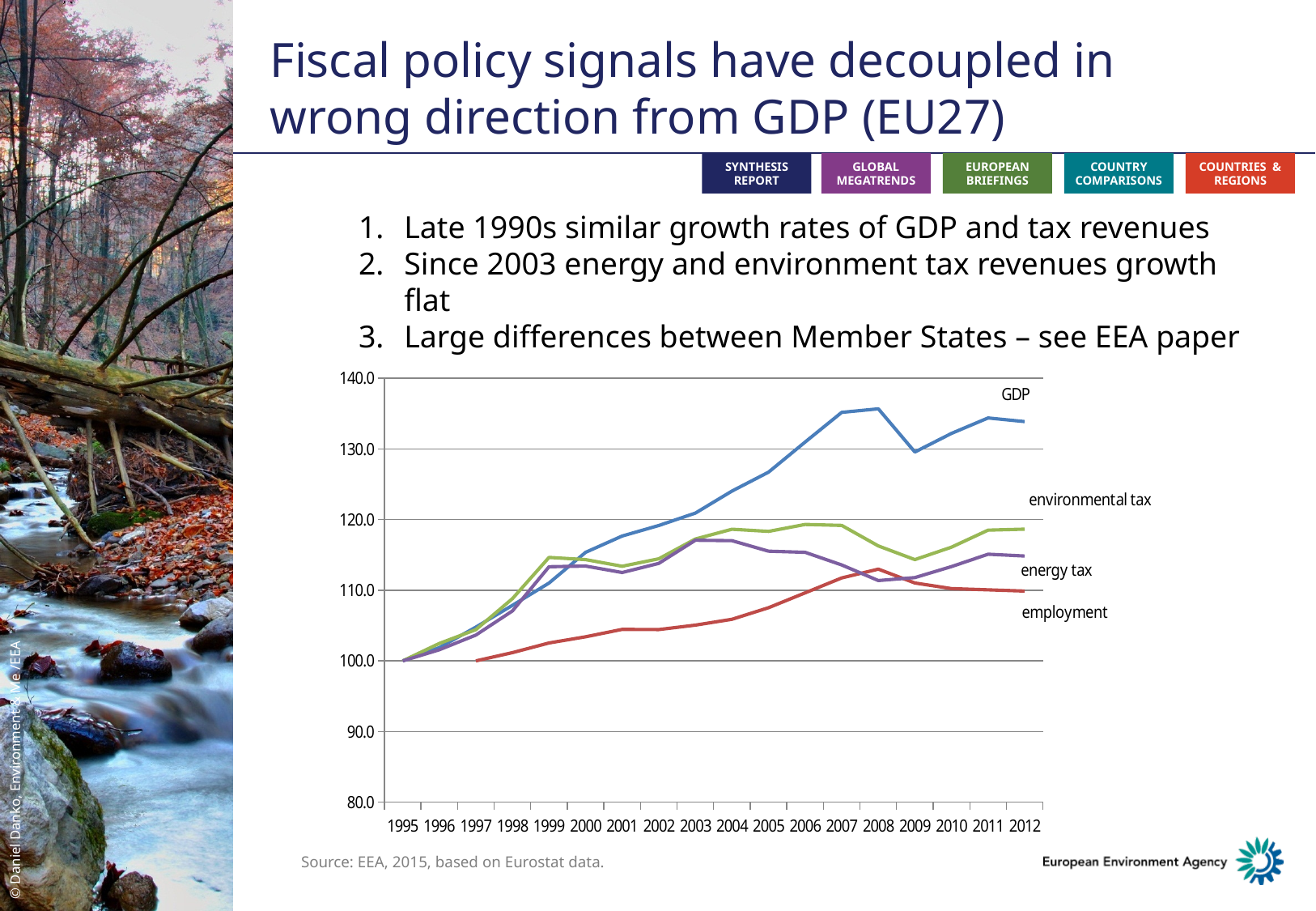
How many years are shown along the x axis of the chart? 18 In 2012, which is larger: energy tax or employment? energy tax Is the value for energy tax in 2012 greater or less than 110? greater Which series has the highest value in 2012? GDP What kind of chart is shown on the slide? line chart Does the GDP series rise or fall between 1995 and 2007? rise How many series are labelled on the chart? 4 Which series has the lowest value in 2012? employment Is the value for GDP in 2007 greater or less than 130? greater In which year does the employment series start on the chart? 1997 Is the value for employment in 2004 greater or less than 110? less